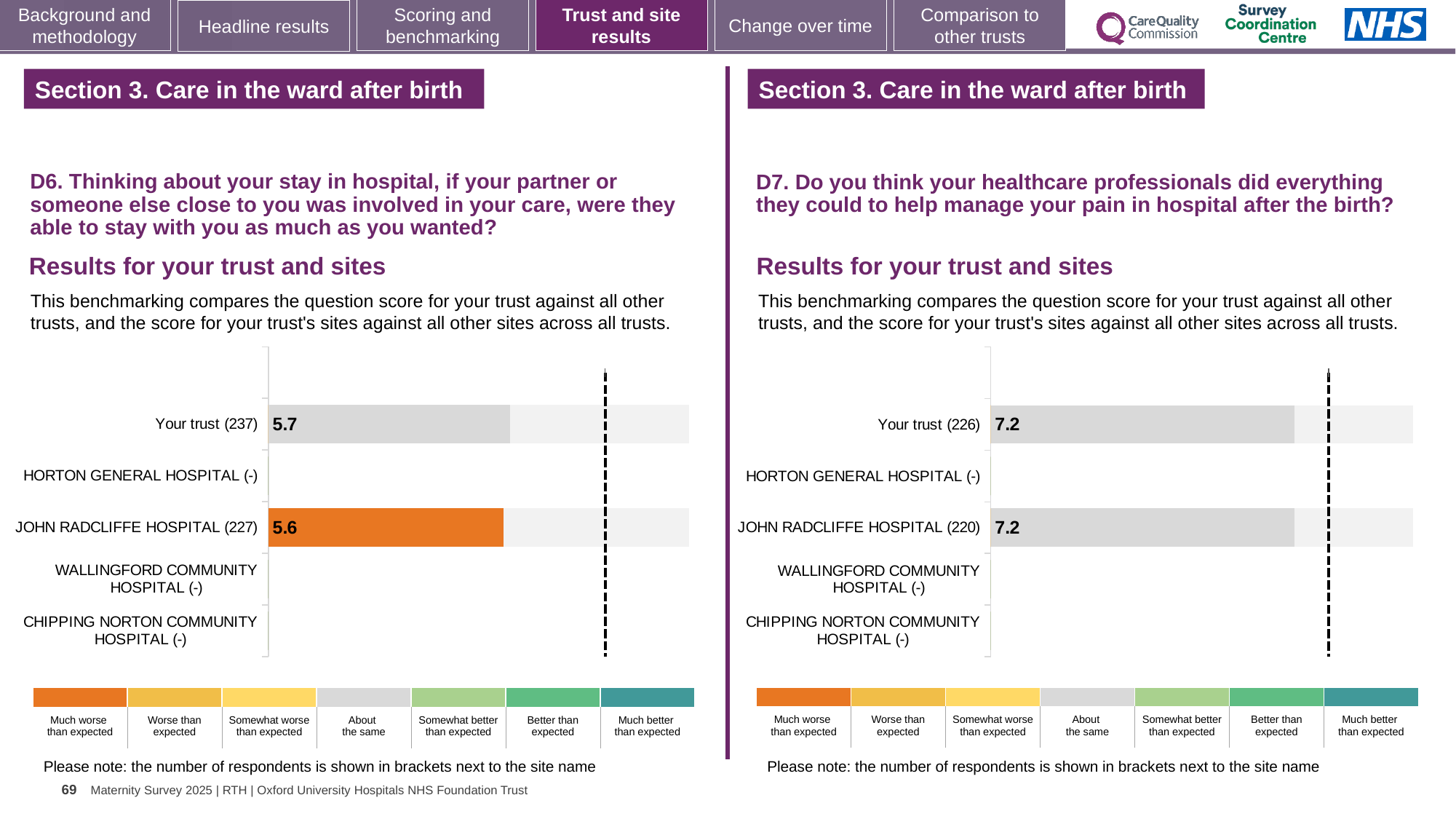
In the D7 chart on the right, what is the score for Your trust? 7.2 How many site/trust categories are listed on the y axis of the D7 chart on the right? 5 In the D6 chart on the left, what is the difference between the score for Your trust and the score for JOHN RADCLIFFE HOSPITAL? 0.1 In the D7 chart on the right, what is the score for JOHN RADCLIFFE HOSPITAL? 7.2 In the D7 chart on the right, which benchmark category does the grey colour of the Your trust bar correspond to in the legend? About the same What kind of chart is the D6 chart on the left? Bar chart In the D6 chart on the left, which has the higher score: Your trust or JOHN RADCLIFFE HOSPITAL? Your trust In the D6 chart on the left, what is the score for JOHN RADCLIFFE HOSPITAL? 5.6 In the D6 chart on the left, which benchmark category does the orange colour of the JOHN RADCLIFFE HOSPITAL bar correspond to in the legend? Much worse than expected In the D6 chart on the left, how many respondents are shown in brackets for Your trust? 237 In the D6 chart on the left, what is the score for Your trust? 5.7 In the D7 chart on the right, how many respondents are shown in brackets for JOHN RADCLIFFE HOSPITAL? 220